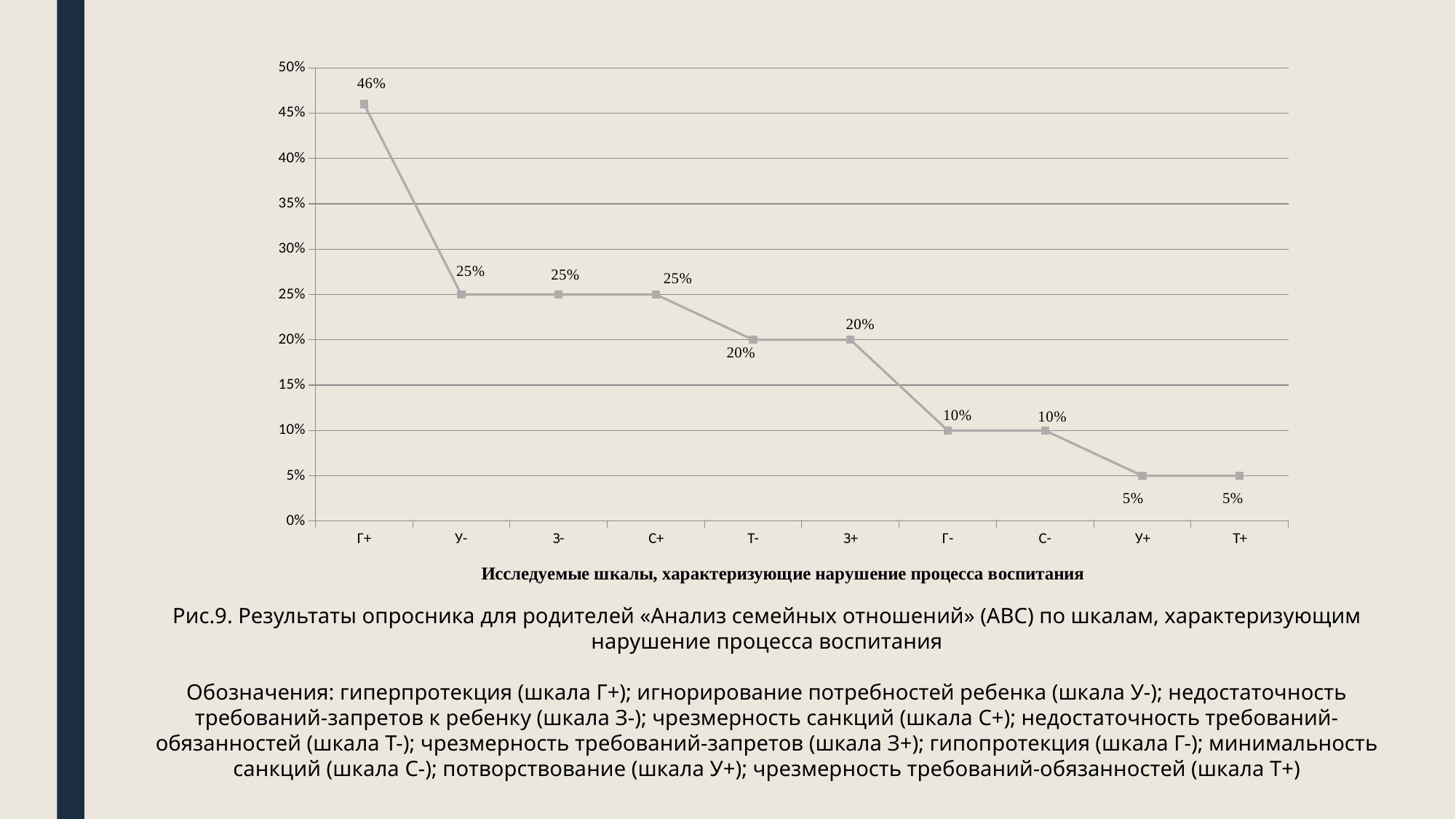
Is the value for Г+ greater or less than 40%? greater How many scales are plotted on the x axis? 10 What kind of chart is shown on the slide? line chart What is the value for the С- scale? 10% Which is larger, the value for С+ or the value for Т-? С+ What is the difference between the values for З+ and Г-? 10% What is the difference between the values for Г+ and У-? 21% What is the value for the Г+ scale? 46% What is the value for the Т- scale? 20% Do the values rise or fall from left to right along the x axis? fall Which scale has the highest value? Г+ What is the x-axis title of the chart? Исследуемые шкалы, характеризующие нарушение процесса воспитания